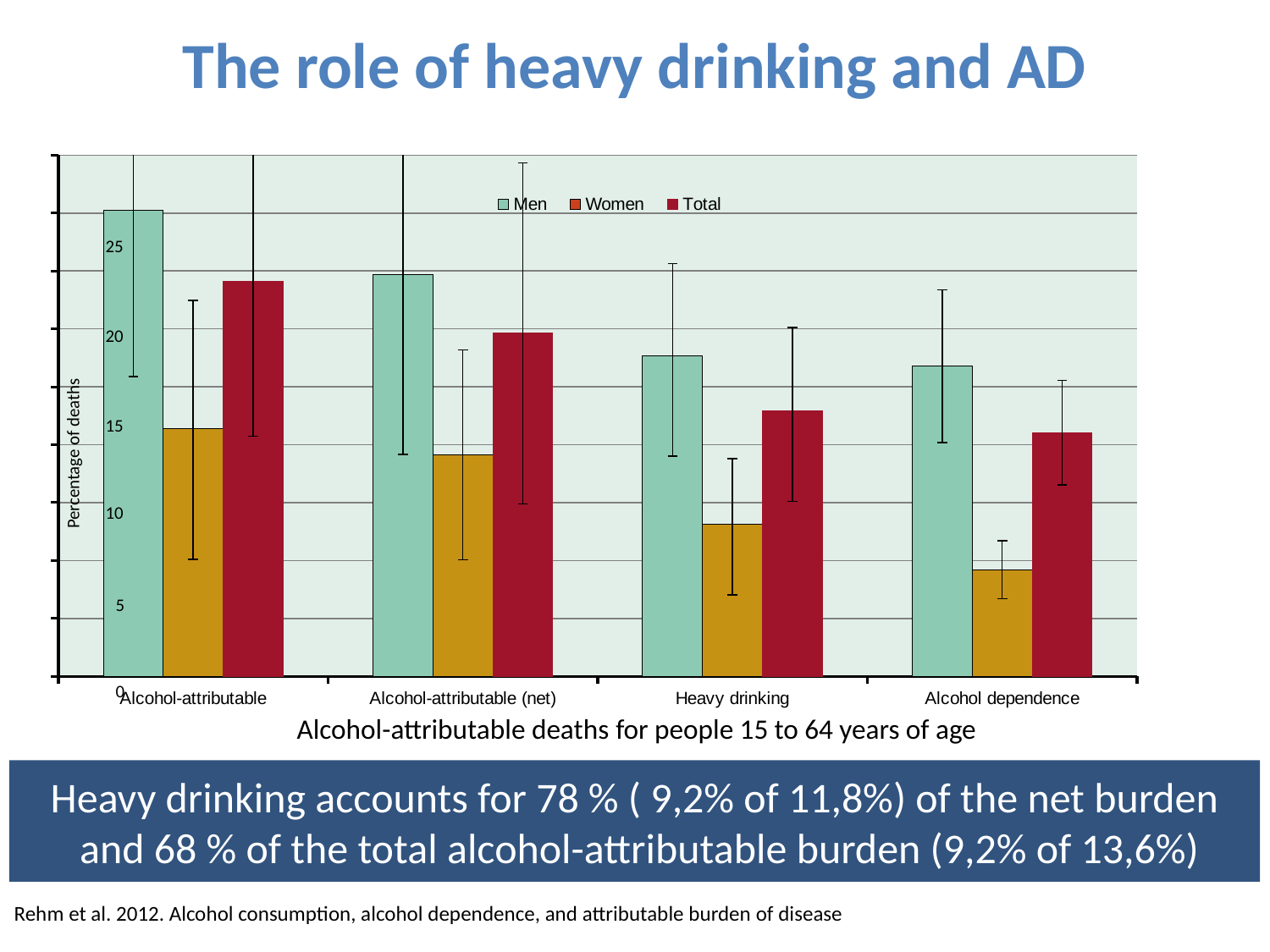
Which category has the lowest bar for Women? Alcohol dependence How many series does the chart's legend list? 3 Is the Women bar for Alcohol-attributable taller or shorter than the Women bar for Heavy drinking? taller In the Heavy drinking category, which series has the tallest bar? Men In the Alcohol dependence category, is the bar for Men or for Total taller? Men What is the label of the vertical axis of the chart? Percentage of deaths Which category has the highest bar for Men? Alcohol-attributable What kind of chart is shown on the slide? bar chart Which series are listed in the chart's legend? Men, Women, Total How many categories are shown along the x axis of the chart? 4 Do the Total bars rise or fall moving from Alcohol-attributable to Alcohol dependence along the x axis? fall